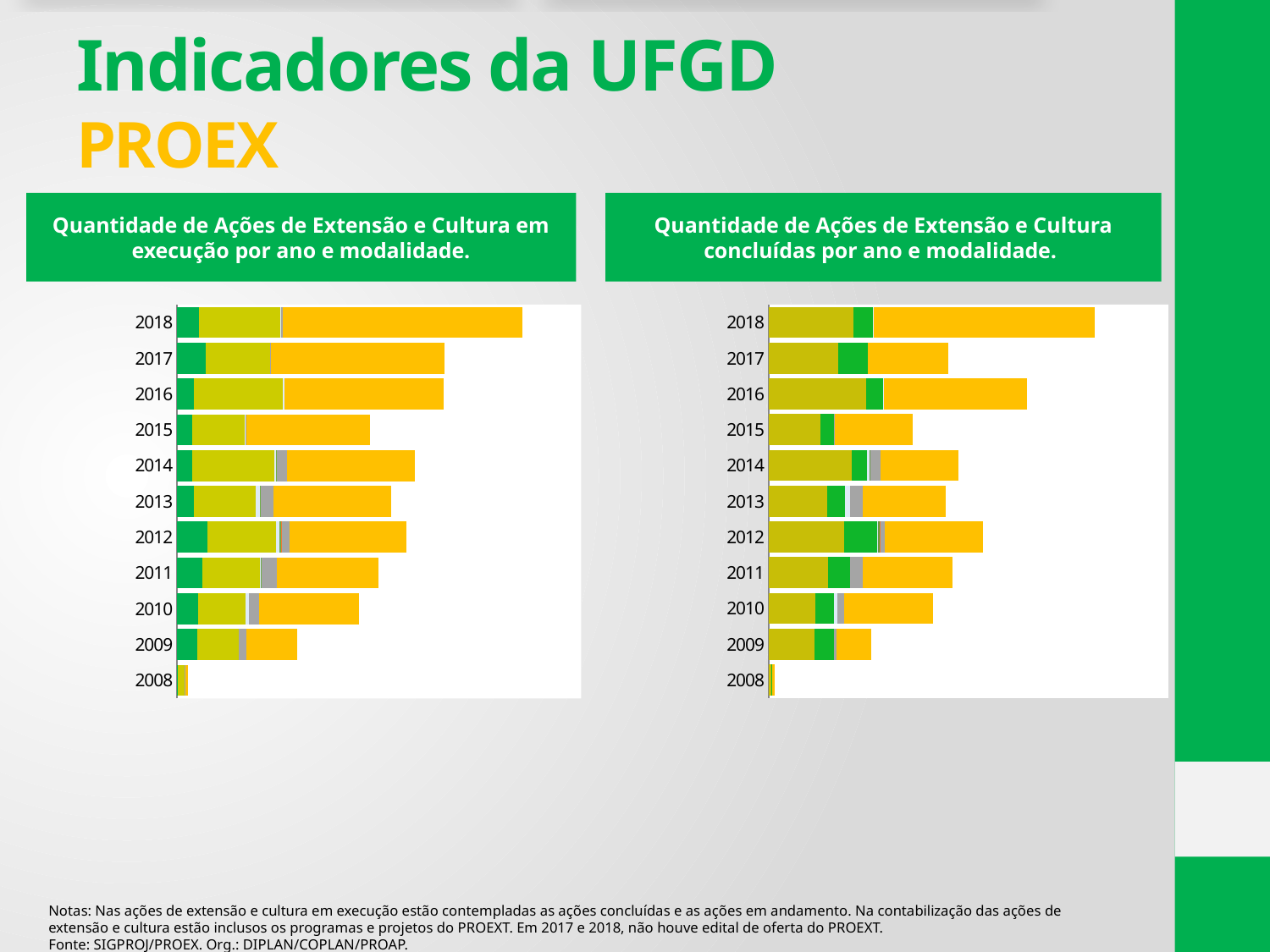
What type of chart is the chart titled "Quantidade de Ações de Extensão e Cultura concluídas por ano e modalidade"? Stacked bar chart In the left chart (ações em execução), which year has the shortest total bar? 2008 In the right chart (ações concluídas), how many years are shown on the vertical axis? 11 What type of chart is the chart titled "Quantidade de Ações de Extensão e Cultura em execução por ano e modalidade"? Stacked bar chart In the right chart (ações concluídas), is the total bar for 2016 longer or shorter than the total bar for 2015? Longer What is the earliest year shown on the vertical axis of the right chart (ações concluídas)? 2008 In the left chart (ações em execução), do the total bars generally increase or decrease from 2008 to 2018? Increase In the left chart (ações em execução), is the total bar for 2018 longer or shorter than the total bar for 2017? Longer In the right chart (ações concluídas), which year has the shortest total bar? 2008 In the right chart (ações concluídas), which year has the longest total bar? 2018 In the left chart (ações em execução), how many years are shown on the vertical axis? 11 In the left chart (ações em execução), which year has the longest total bar? 2018